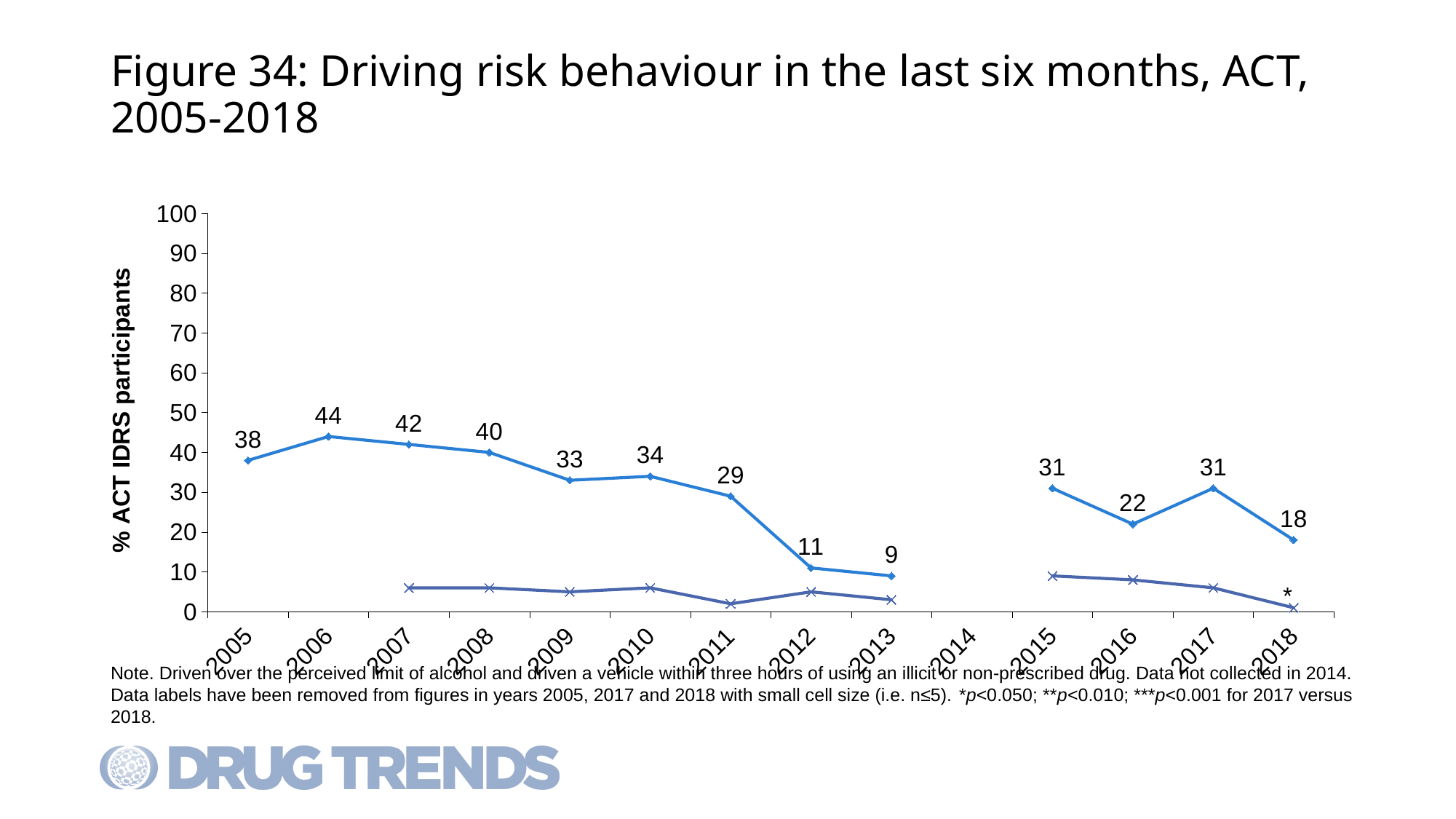
What is the data label on the upper line for 2006? 44 What is the data label on the upper line for 2018? 18 What is the data label on the upper line for 2013? 9 Is the value of the upper line for 2011 greater or less than 20? greater What is the label on the vertical axis? % ACT IDRS participants How many lines are plotted on the chart? 2 In which year does the upper line reach its highest labelled value? 2006 Which year has the larger value on the upper line, 2012 or 2016? 2016 What is the difference between the upper line's values for 2017 and 2018? 13 In which year does the upper line reach its lowest labelled value? 2013 What type of chart is shown on the slide? line chart Is the value of the lower line (x markers) for 2007 greater or less than 10? less